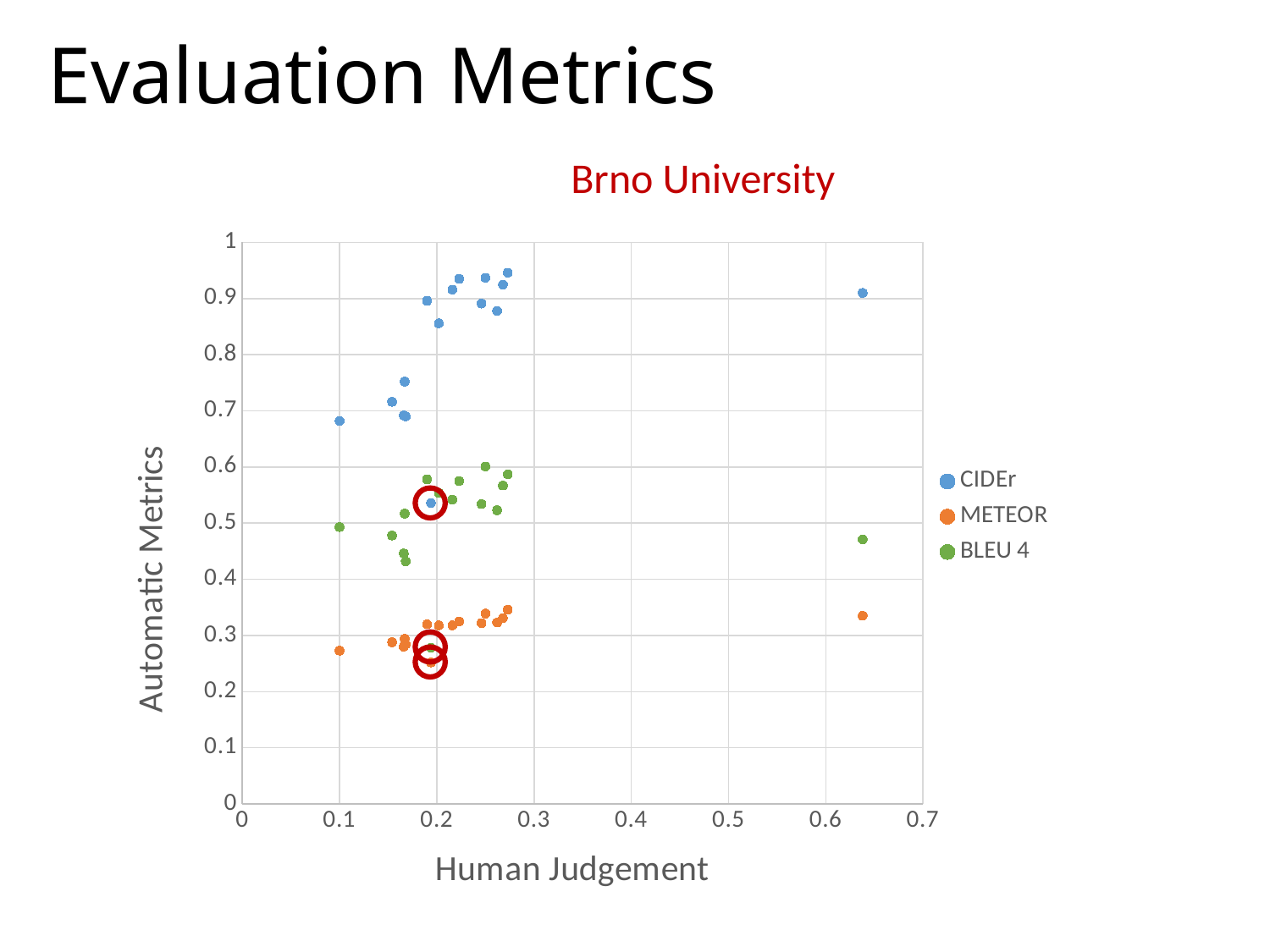
Is the METEOR point at Human Judgement of about 0.1 greater or less than 0.3 on the Automatic Metrics axis? less Which series has the lowest Automatic Metrics values overall? METEOR What is the label of the x axis? Human Judgement How many series does the legend list? 3 Is the CIDEr point at Human Judgement of about 0.1 greater or less than 0.6 on the Automatic Metrics axis? greater Which series has the highest Automatic Metrics values overall? CIDEr Is the BLEU 4 point at Human Judgement of about 0.64 greater or less than 0.5 on the Automatic Metrics axis? less What are the three series named in the legend? CIDEr, METEOR, BLEU 4 Do the CIDEr values generally rise or fall as Human Judgement increases from 0.1 to 0.3? rise At Human Judgement of about 0.64, which series has the larger Automatic Metrics value, CIDEr or BLEU 4? CIDEr What kind of chart is shown on the slide? scatter chart